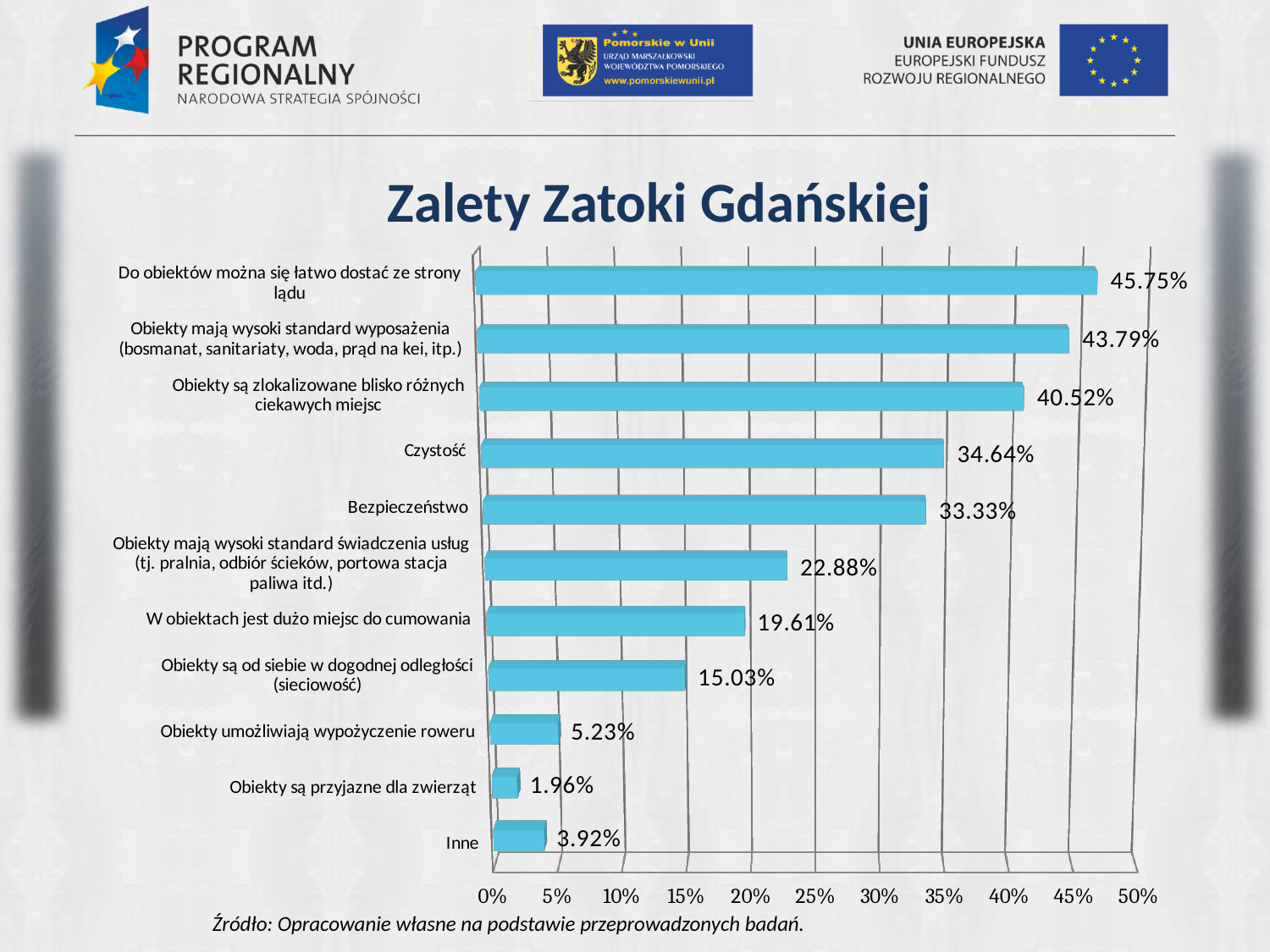
What is the value for "Bezpieczeństwo"? 33.33% What kind of chart is shown on the slide? bar chart What is the title of the chart? Zalety Zatoki Gdańskiej Is the value for "Obiekty są zlokalizowane blisko różnych ciekawych miejsc" greater or less than 40%? greater What is the value for "Inne"? 3.92% Which category has the highest value? Do obiektów można się łatwo dostać ze strony lądu What is the value for "Obiekty umożliwiają wypożyczenie roweru"? 5.23% Which category has the lowest value? Obiekty są przyjazne dla zwierząt Which is larger: the value for "W obiektach jest dużo miejsc do cumowania" or the value for "Obiekty są od siebie w dogodnej odległości (sieciowość)"? W obiektach jest dużo miejsc do cumowania What is the value for "Czystość"? 34.64% What is the difference between the values for "Czystość" and "Bezpieczeństwo"? 1.31% How many categories are shown in the chart? 11